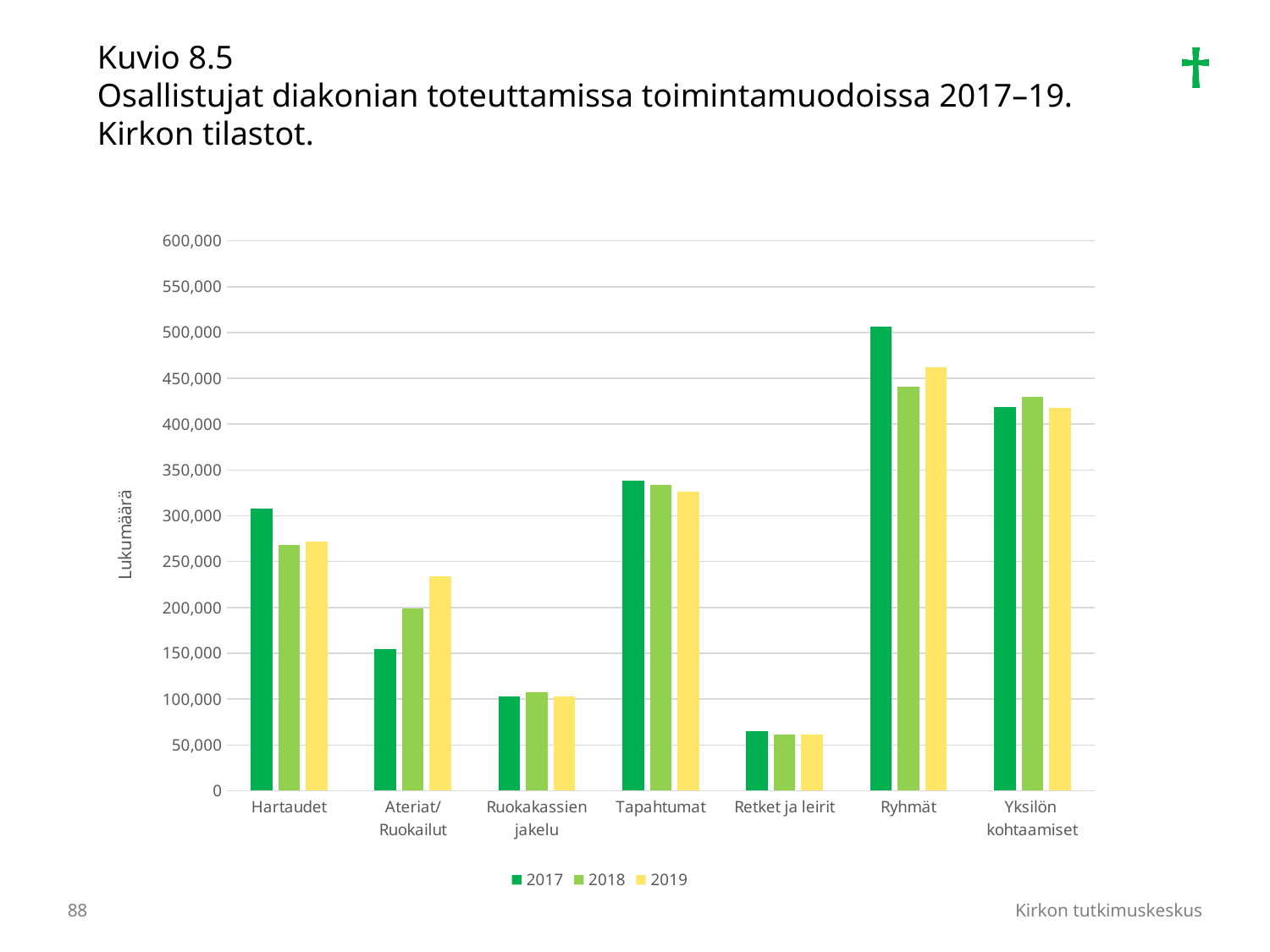
Do the values for Ateriat/Ruokailut rise or fall from 2017 to 2019? rise What kind of chart is shown on the slide? Bar chart For Ryhmät, which year has the larger value, 2017 or 2019? 2017 For Ateriat/Ruokailut, which year has the larger value, 2017 or 2019? 2019 Is the value for Hartaudet in 2017 greater or less than 250,000? greater Is the value for Tapahtumat in 2019 greater or less than 300,000? greater Is the value for Ryhmät in 2017 greater or less than 450,000? greater Which category has the lowest value for 2017? Retket ja leirit How many categories are shown on the x axis? 7 How many series does the legend list? 3 Which category has the highest value for 2017? Ryhmät